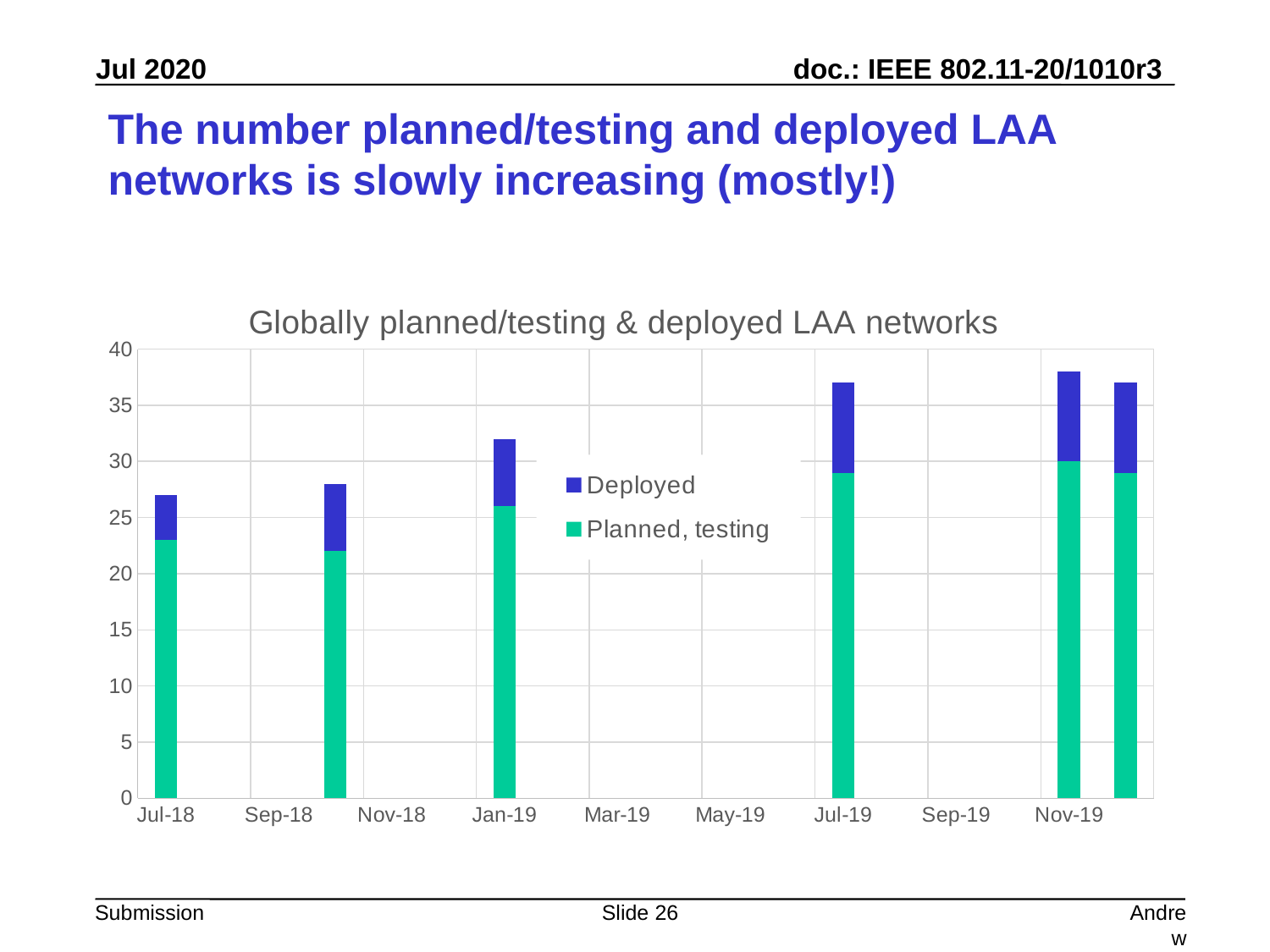
Which bar has the larger total, Jan-19 or Jul-19? Jul-19 Is the 'Planned, testing' value for Jan-19 greater or less than 25? greater How many stacked bars are plotted in the chart? 6 What type of chart is shown on the slide? Stacked bar chart Is the 'Planned, testing' value for Jul-18 greater or less than 20? greater Do the total bar heights generally rise or fall from Jul-18 to Nov-19? Rise What is the title of the chart? Globally planned/testing & deployed LAA networks Is the total height of the Jul-19 bar greater or less than 40? less How many series does the legend list? 2 Which colour represents the 'Deployed' series? Blue